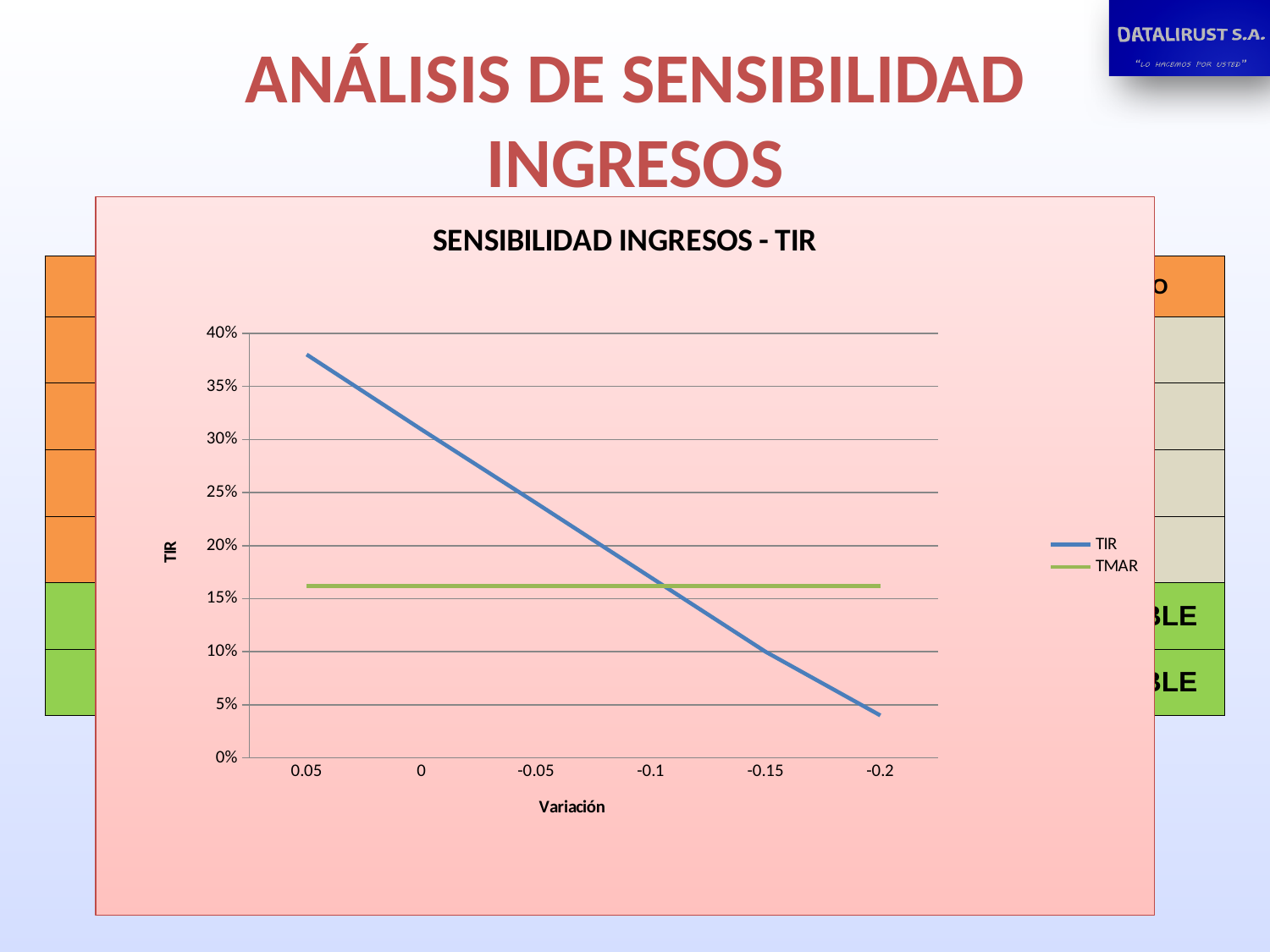
At which Variación value is TIR highest? 0.05 Does the TIR line rise or fall as you move from 0.05 to -0.2 along the x axis? fall At Variación 0.05, which is larger, TIR or TMAR? TIR What is the title of the chart? SENSIBILIDAD INGRESOS - TIR Is the TMAR value greater or less than 20%? less How many series does the legend list? 2 At Variación -0.2, which is larger, TIR or TMAR? TMAR Is the TIR value at Variación -0.2 greater or less than 10%? less What kind of chart is shown on the slide? line chart Is the TIR value at Variación 0.05 greater or less than 35%? greater How many points are plotted along the Variación axis? 6 At which Variación value is TIR lowest? -0.2